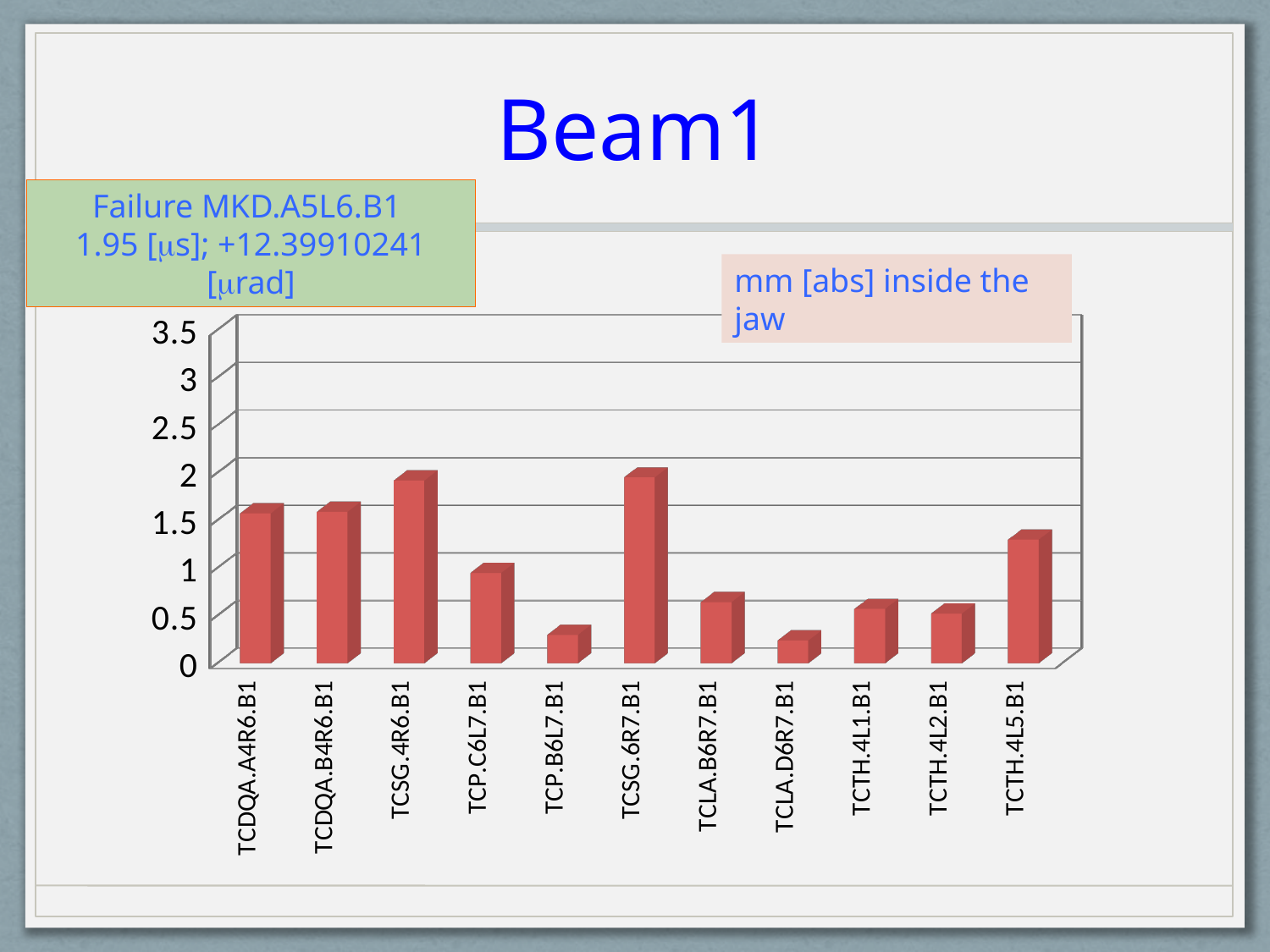
What is the highest tick value shown on the vertical axis? 3.5 Is the value for TCDQA.A4R6.B1 greater or less than 2? less Is the value for TCSG.4R6.B1 greater or less than 1.5? greater Which has the larger value, TCDQA.B4R6.B1 or TCTH.4L2.B1? TCDQA.B4R6.B1 According to the label on the slide, what unit do the plotted values represent? mm [abs] inside the jaw How many collimators (categories) are plotted on the x axis? 11 Which has the larger value, TCSG.4R6.B1 or TCP.C6L7.B1? TCSG.4R6.B1 Is the value for TCLA.D6R7.B1 greater or less than 0.5? less What kind of chart is shown on the slide? bar chart Which has the larger value, TCTH.4L5.B1 or TCLA.B6R7.B1? TCTH.4L5.B1